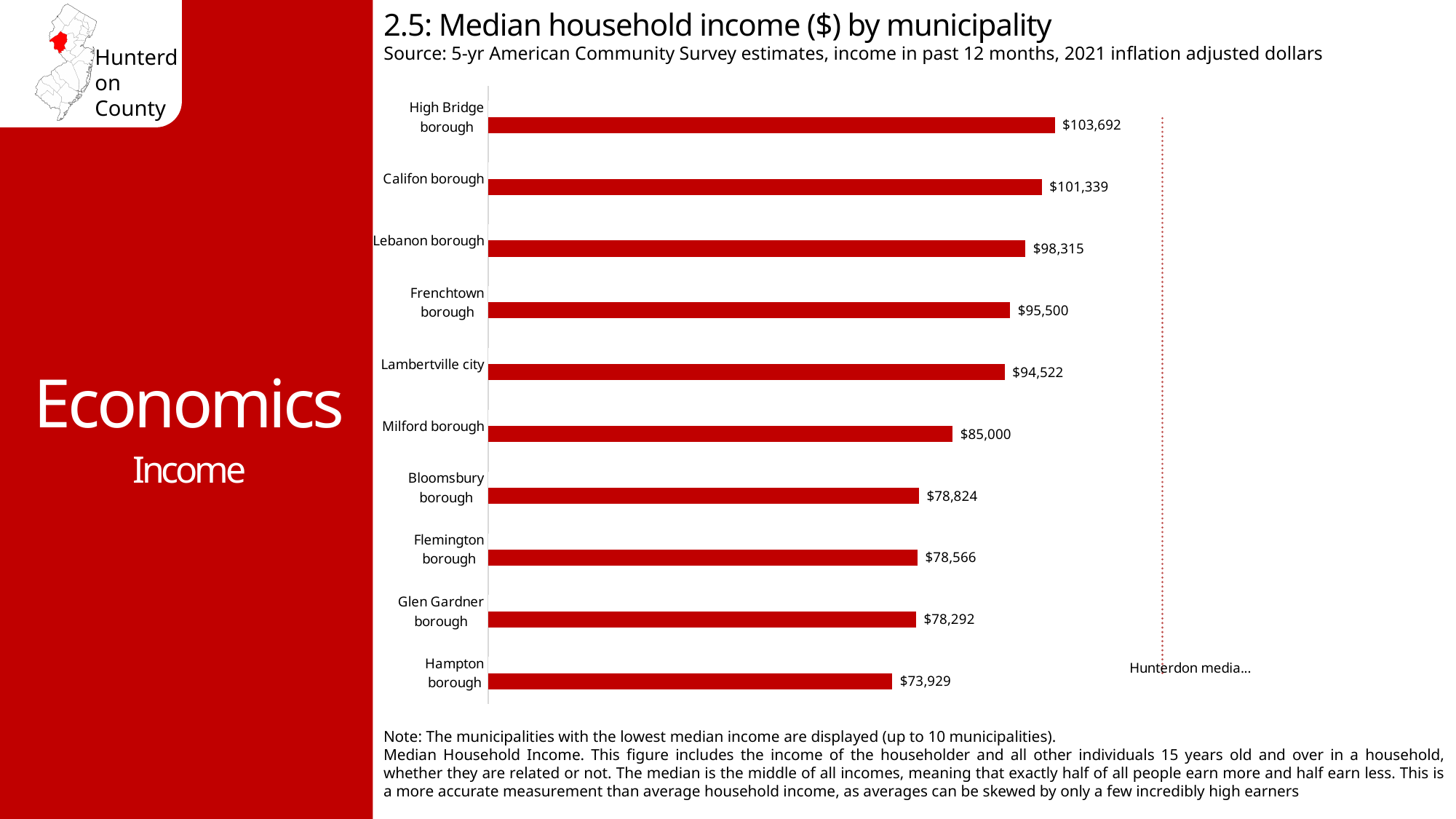
What is the median household income for Lambertville city? $94,522 What is the median household income for Glen Gardner borough? $78,292 What is the median household income for Milford borough? $85,000 What is the difference in median household income between Lebanon borough and Milford borough? $13,315 What is the median household income for High Bridge borough? $103,692 Which municipality has the highest median household income shown on the chart? High Bridge borough What is the title of the chart? 2.5: Median household income ($) by municipality What is the difference in median household income between High Bridge borough and Hampton borough? $29,763 Which municipality has the lowest median household income shown on the chart? Hampton borough Which has a higher median household income, Califon borough or Frenchtown borough? Califon borough What kind of chart is used to show median household income by municipality? Bar chart How many municipalities are shown on the chart? 10